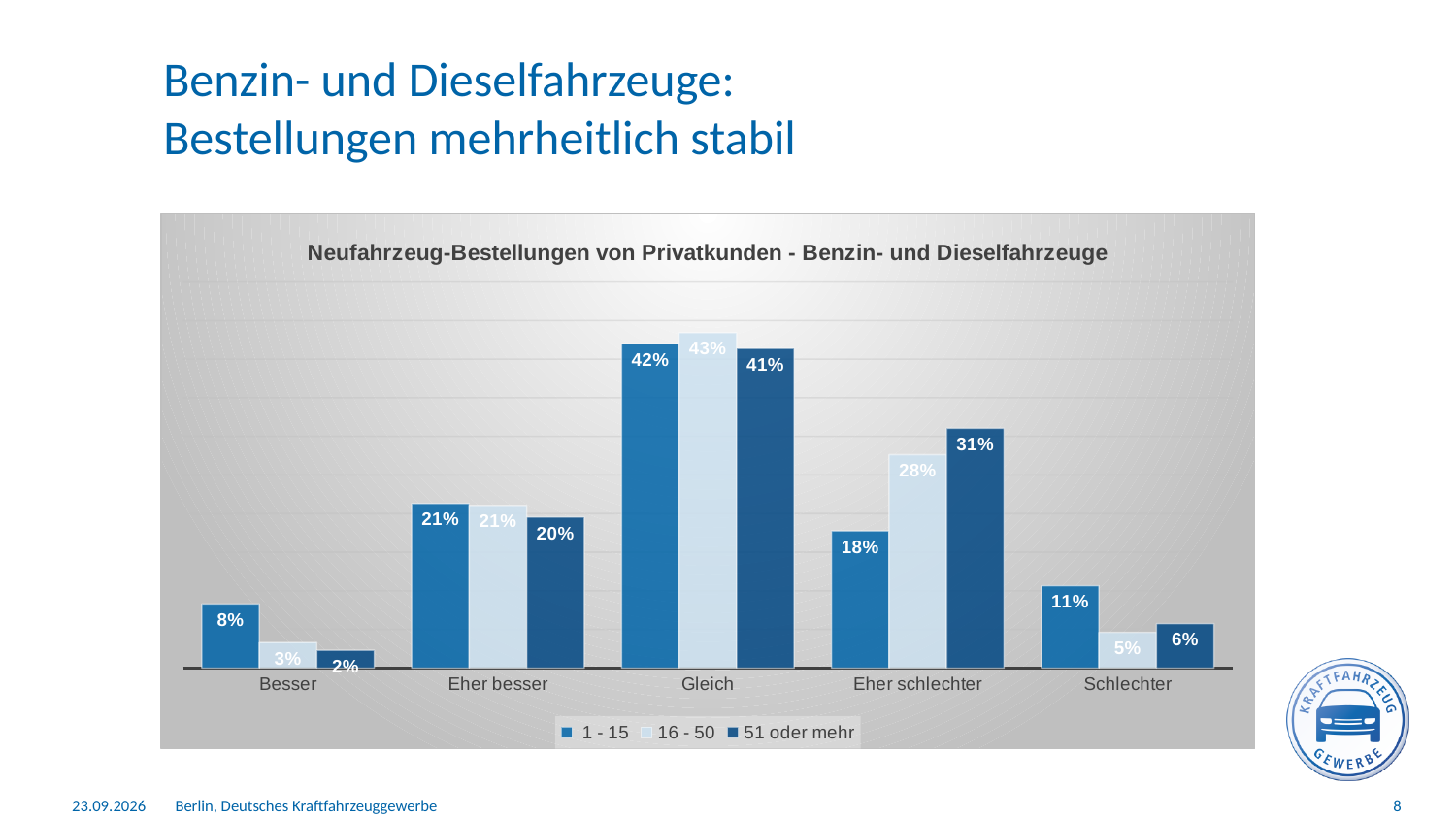
How many series does the legend list? 3 What is the difference between the "51 oder mehr" and "1 - 15" values for "Eher schlechter"? 13% What is the title of the chart? Neufahrzeug-Bestellungen von Privatkunden - Benzin- und Dieselfahrzeuge What is the value for "Gleich" in the "1 - 15" series? 42% For "Schlechter", which series has the larger value: "1 - 15" or "51 oder mehr"? 1 - 15 How many categories are shown on the x axis? 5 What is the value for "Eher schlechter" in the "51 oder mehr" series? 31% What is the value for "Besser" in the "16 - 50" series? 3% What is the value for "Eher besser" in the "51 oder mehr" series? 20% What kind of chart is shown on the slide? Bar chart Which category has the highest value in the "16 - 50" series? Gleich Which category has the lowest value in the "51 oder mehr" series? Besser